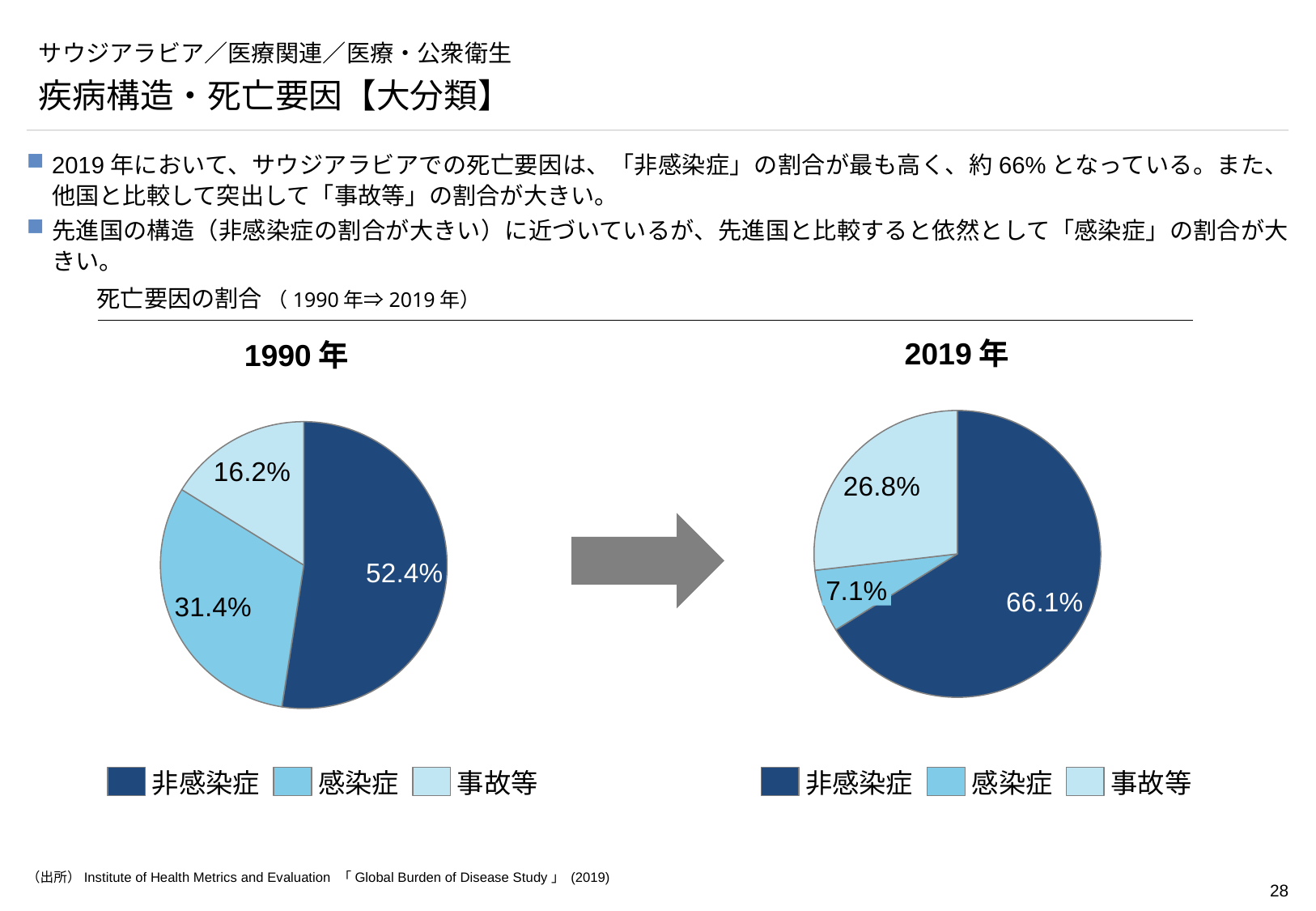
In the 2019年 pie chart, what is the share for 感染症? 7.1% What is the difference between the 非感染症 share in the 2019年 pie chart and in the 1990年 pie chart? 13.7% In the 1990年 pie chart, what is the share for 感染症? 31.4% In the 1990年 pie chart, which category has the smallest share? 事故等 What type of chart is used for the 1990年 and 2019年 figures? Pie chart Which is larger: the 事故等 share in the 1990年 pie chart or in the 2019年 pie chart? 2019年 In the 1990年 pie chart, what is the difference between the 感染症 share and the 事故等 share? 15.2% In the 2019年 pie chart, which category has the smallest share? 感染症 In the 2019年 pie chart, which category has the largest share? 非感染症 In the 2019年 pie chart, what is the share for 事故等? 26.8% In the 1990年 pie chart, what is the share for 非感染症? 52.4% How many categories does the legend of the 2019年 pie chart list? 3